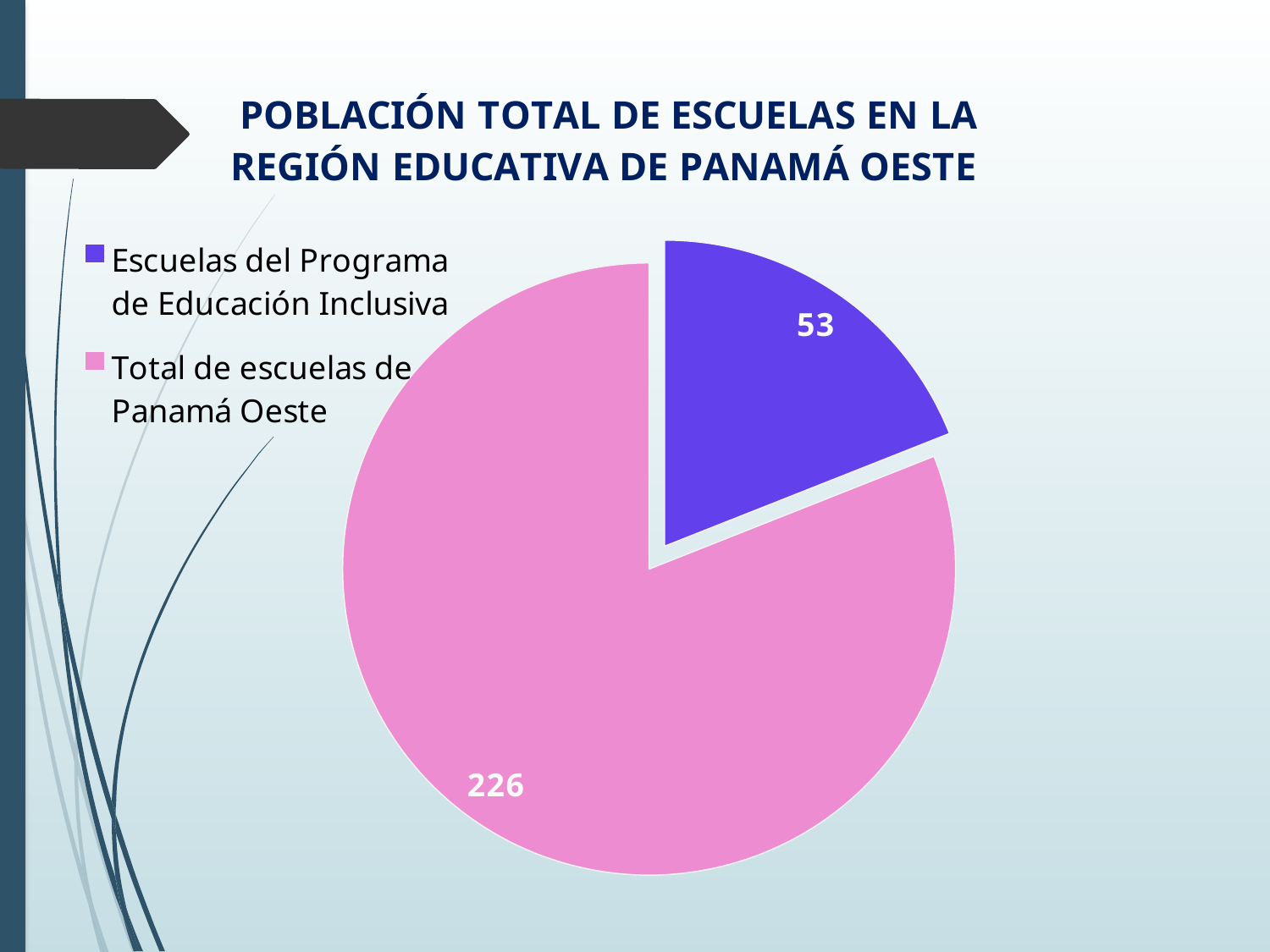
What is the title of the chart? POBLACIÓN TOTAL DE ESCUELAS EN LA REGIÓN EDUCATIVA DE PANAMÁ OESTE What is the difference between the value for Total de escuelas de Panamá Oeste and the value for Escuelas del Programa de Educación Inclusiva? 173 Which category has the largest slice of the pie? Total de escuelas de Panamá Oeste How many slices does the pie chart have? 2 How many entries does the legend list? 2 What is the value for Total de escuelas de Panamá Oeste? 226 What type of chart is shown on the slide? Pie chart What is the value for Escuelas del Programa de Educación Inclusiva? 53 What colour is the slice for Total de escuelas de Panamá Oeste? Pink Which category has the smallest slice of the pie? Escuelas del Programa de Educación Inclusiva Which is larger: the value for Escuelas del Programa de Educación Inclusiva or the value for Total de escuelas de Panamá Oeste? Total de escuelas de Panamá Oeste What is the sum of the two values shown in the pie chart? 279